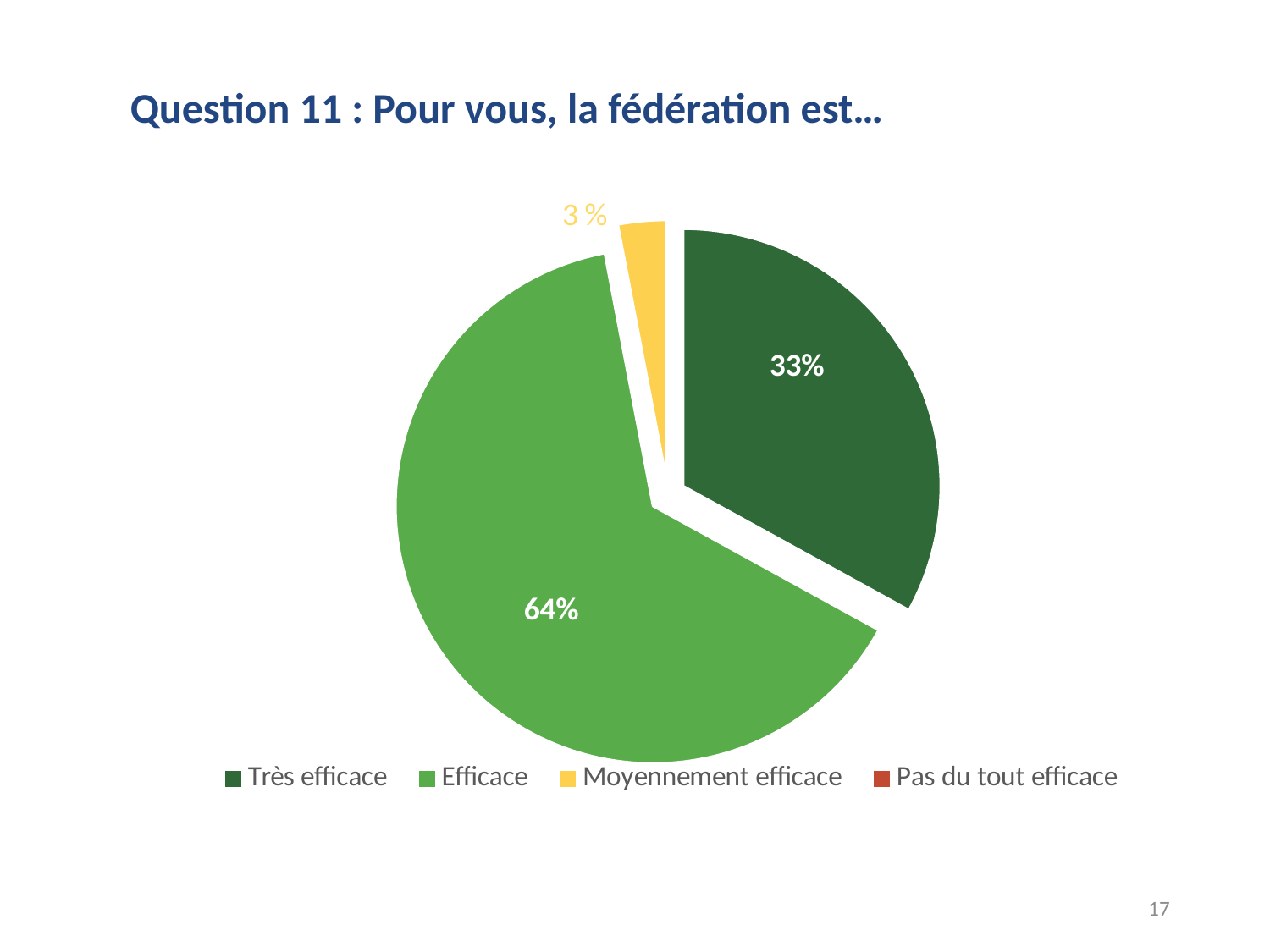
What is the difference in percentage points between "Efficace" and "Très efficace"? 31 What percentage of respondents answered "Très efficace"? 33% What is the combined share of "Très efficace" and "Efficace"? 97% What kind of chart is shown on the slide? pie chart Which labelled slice has the smallest share of the pie? Moyennement efficace Which is larger, the share for "Très efficace" or the share for "Moyennement efficace"? Très efficace What colour is the "Efficace" slice? green What percentage of respondents answered "Efficace"? 64% What percentage of respondents answered "Moyennement efficace"? 3 % Which category has the largest share of the pie? Efficace How many entries does the legend list? 4 What is the title of the slide? Question 11 : Pour vous, la fédération est…